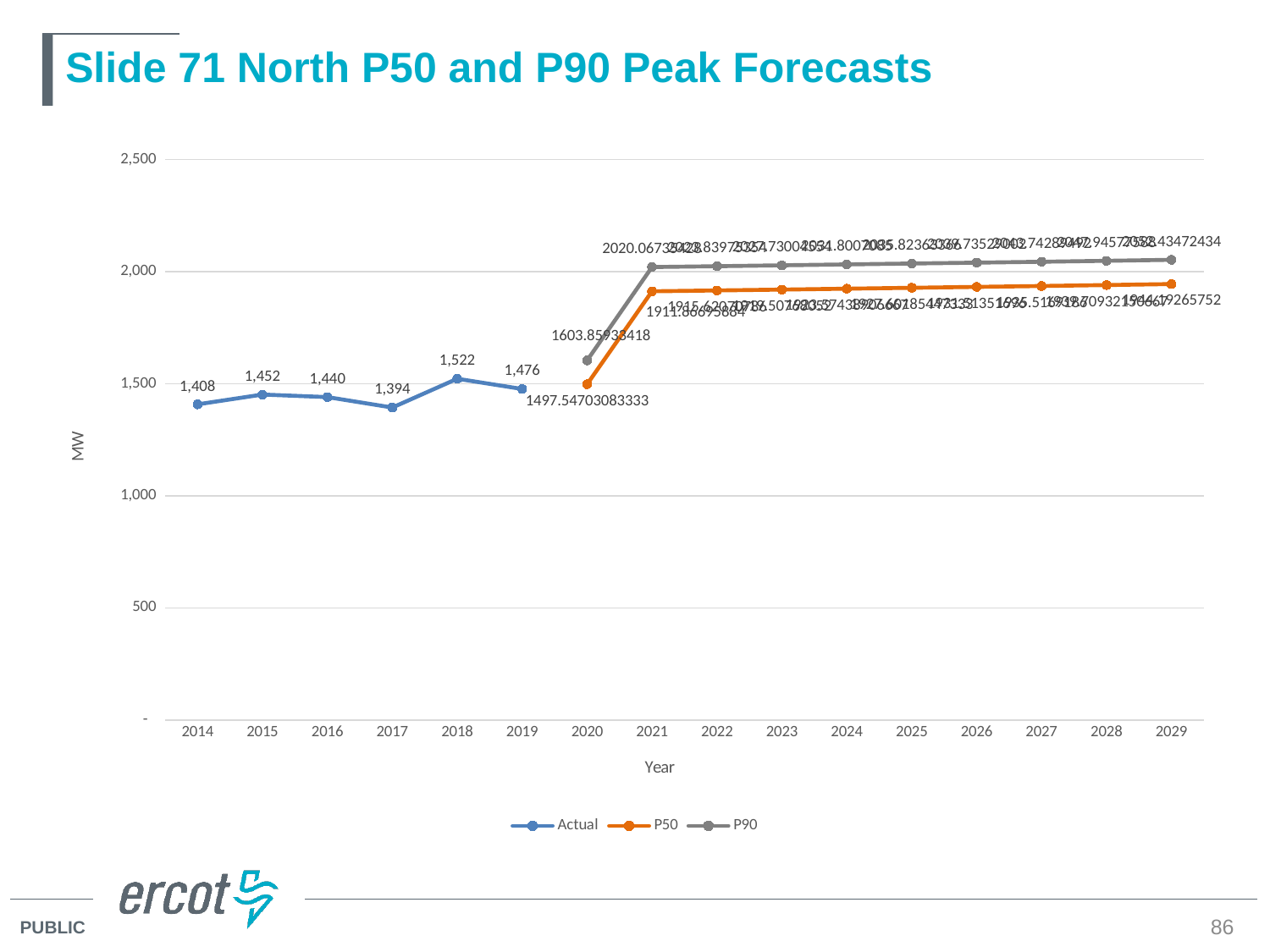
What is the Actual value for 2018? 1,522 Which year has the highest Actual value? 2018 Which is larger, the Actual value for 2015 or for 2016? 2015 What is the Actual value for 2017? 1,394 Which year has the lowest Actual value? 2017 What is the difference between the Actual values for 2018 and 2017? 128 Is the P90 value for 2029 greater or less than 2,000? greater What is the Actual value for 2014? 1,408 What is the P90 value for 2020? 1603.85938418 What kind of chart is shown on the slide? line chart What is the P50 value for 2020? 1497.54703083333 How many series does the legend list? 3